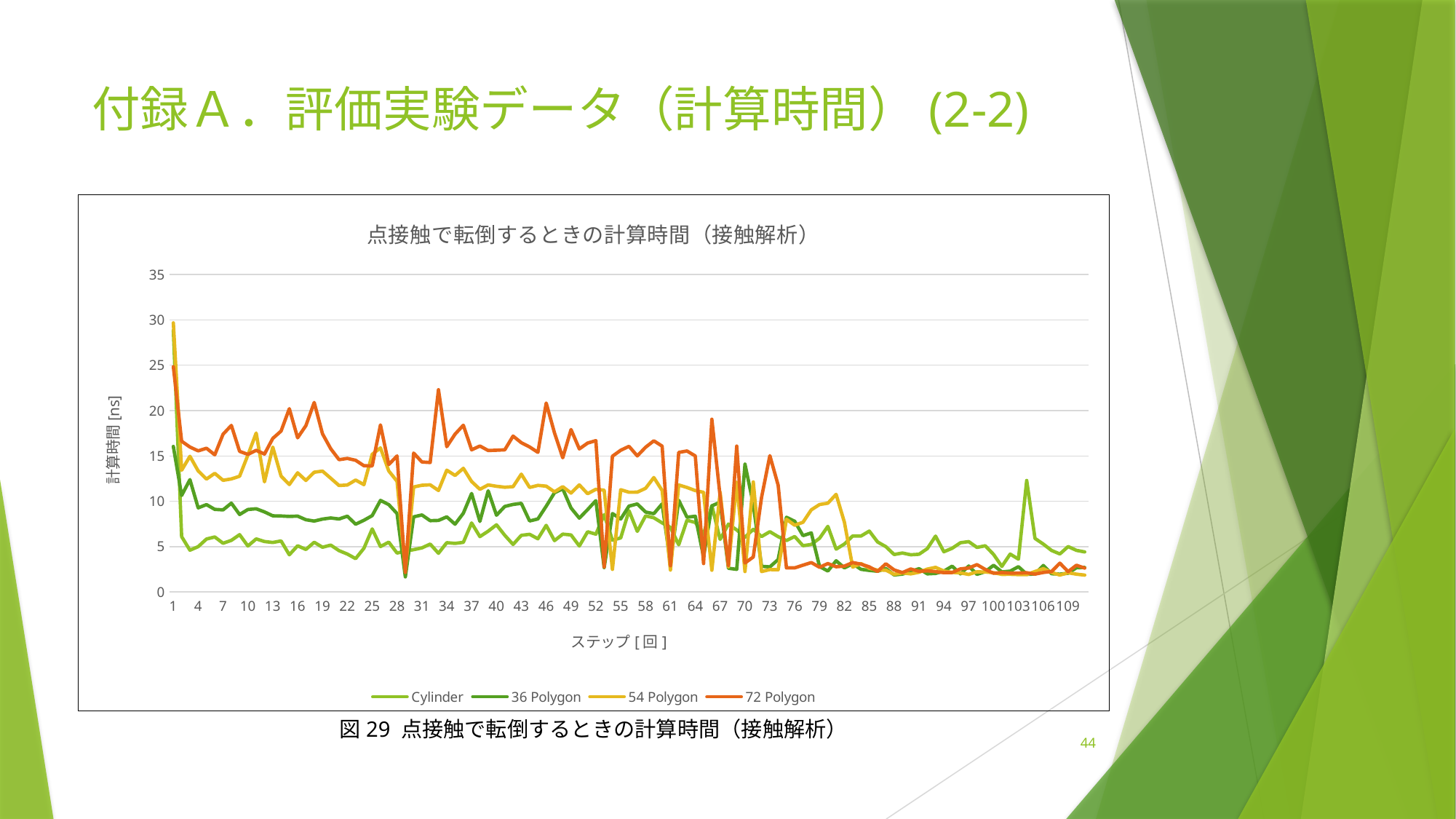
What kind of chart is shown on the slide? line chart Is the value for 36 Polygon at step 1 greater or less than 10? greater Which series has the highest value at step 1? 54 Polygon What is the title of the chart? 点接触で転倒するときの計算時間（接触解析） Do the values for 72 Polygon generally rise or fall as the step number increases? fall What is the label of the y axis? 計算時間 [ns] How many series does the legend list? 4 Which series has the lowest value at step 1? 36 Polygon Is the value for Cylinder at step 103 greater or less than 10? less Is the value for Cylinder at step 1 greater or less than 10? greater